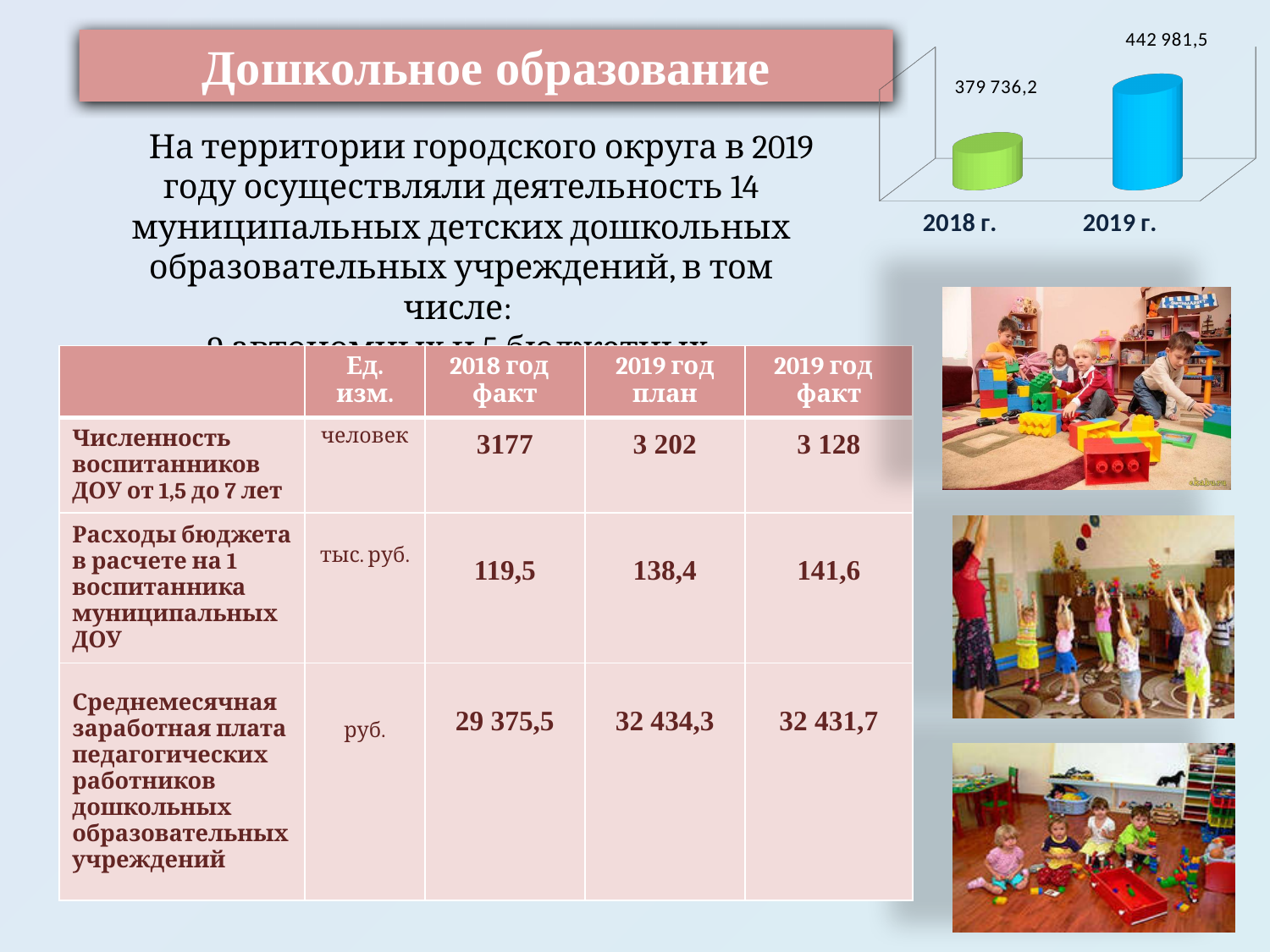
What colour is the bar for 2018 г. in the chart? green Which year has the lower value in the chart? 2018 г. What is the value shown for 2019 г. in the chart? 442 981,5 What colour is the bar for 2019 г. in the chart? blue What kind of chart is shown in the top right of the slide? bar chart How many categories (years) are plotted in the chart? 2 By how much does the value for 2019 г. exceed the value for 2018 г. in the chart? 63 245,3 What is the value shown for 2018 г. in the chart? 379 736,2 Does the value rise or fall from 2018 г. to 2019 г. in the chart? rise Which year has the higher value in the chart? 2019 г. Is the value for 2018 г. larger or smaller than the value for 2019 г. in the chart? smaller